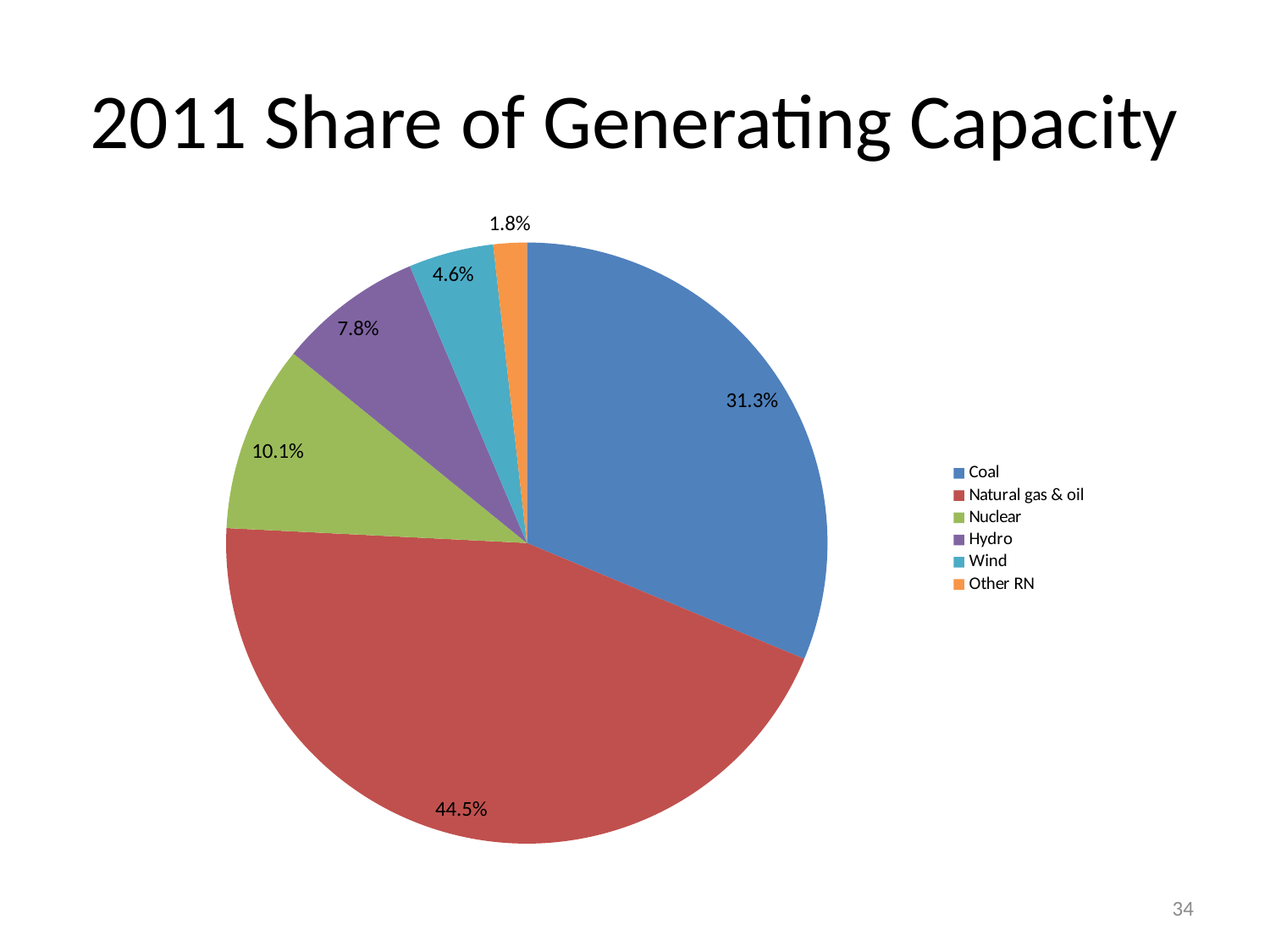
How many categories does the pie chart show? 6 What share of generating capacity does Other RN have? 1.8% Which has a larger share, Nuclear or Hydro? Nuclear Which category has the largest share of generating capacity? Natural gas & oil What share of generating capacity does Wind have? 4.6% What kind of chart is shown on the slide? Pie chart What is the difference between the shares of Natural gas & oil and Coal? 13.2% What share of generating capacity does Nuclear have? 10.1% Which category has the smallest share of generating capacity? Other RN What share of generating capacity does Coal have? 31.3% What share of generating capacity does Natural gas & oil have? 44.5% What share of generating capacity does Hydro have? 7.8%